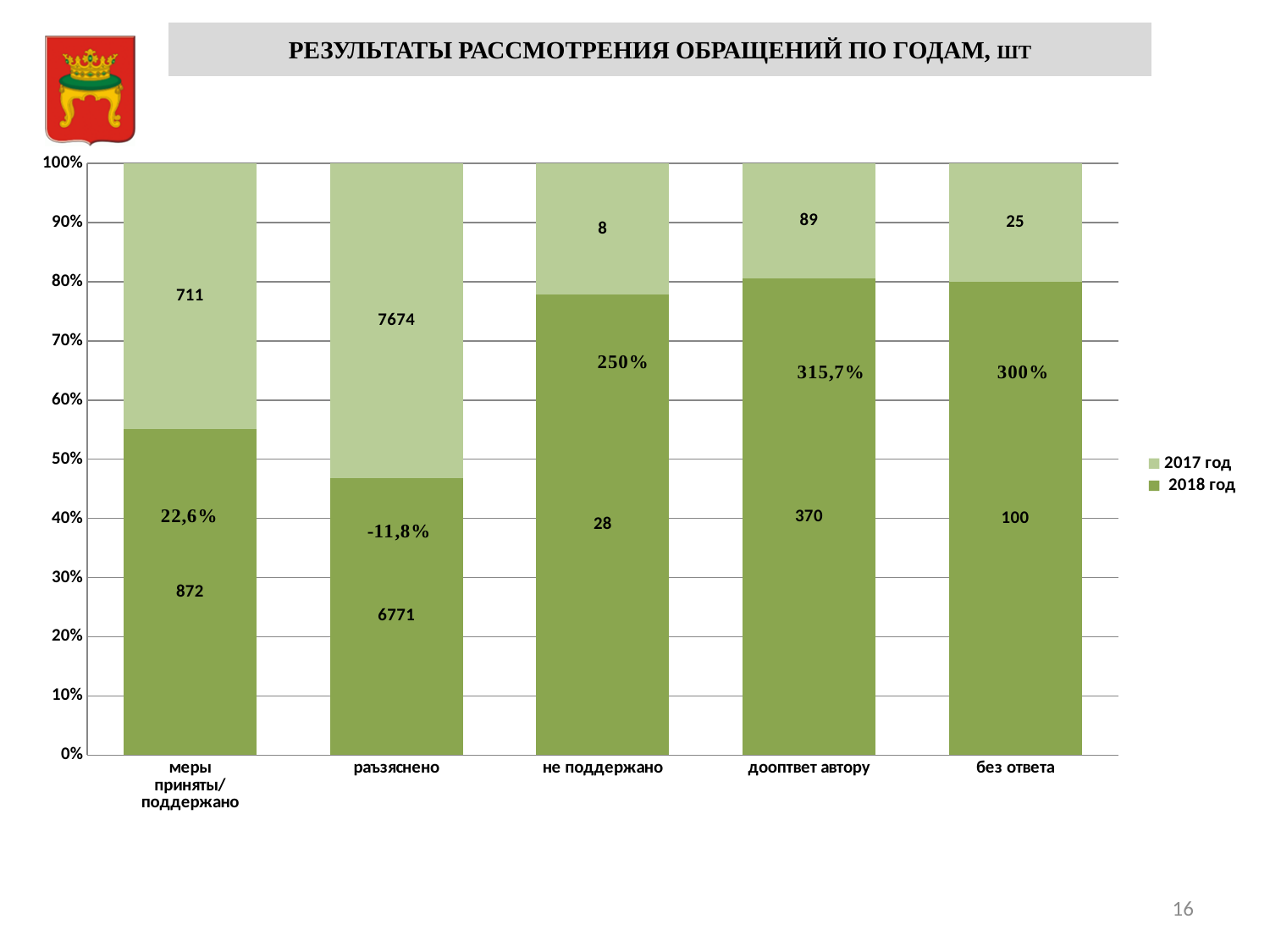
Which category has the lowest value for 2017 год? не поддержано In the category 'не поддержано', which is larger: the 2017 год value or the 2018 год value? 2018 год What is the difference between the 2017 год and 2018 год values in the category 'раъяснено'? 903 What is the value for 2017 год in the category 'раъяснено'? 7674 What is the difference between the 2018 год and 2017 год values in the category 'доопответ автору'? 281 What is the value for 2018 год in the category 'меры приняты/поддержано'? 872 How many series does the legend list? 2 What kind of chart is shown on the slide? Stacked bar chart Which category has the highest value for 2018 год? раъяснено What is the value for 2018 год in the category 'доопответ автору'? 370 What is the value for 2017 год in the category 'без ответа'? 25 How many categories are shown on the x axis? 5